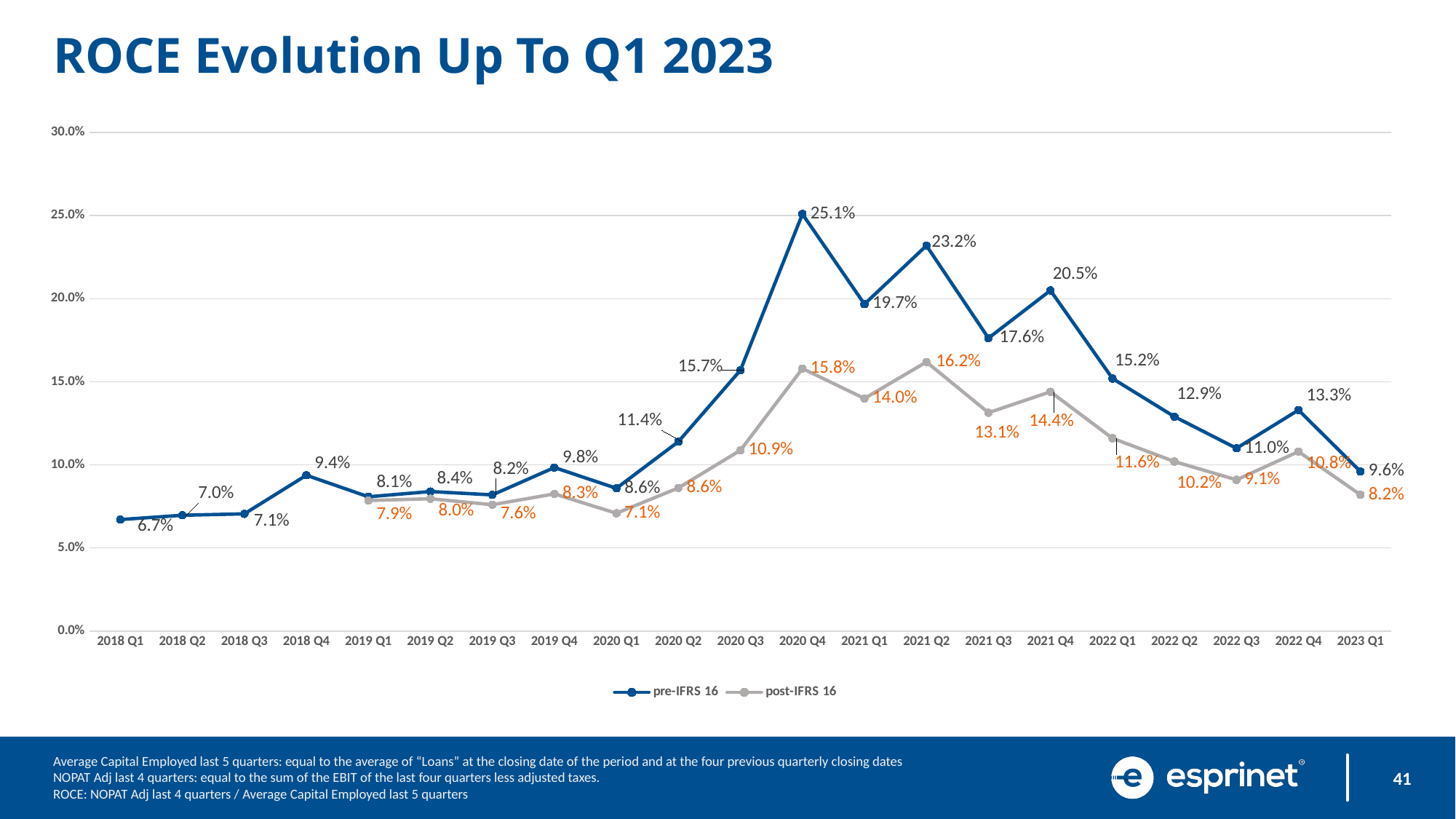
What is the difference between the pre-IFRS 16 and post-IFRS 16 ROCE values in 2020 Q4? 9.3% What kind of chart is shown on the slide? Line chart Does the pre-IFRS 16 ROCE rise or fall from 2020 Q4 to 2023 Q1? Fall How many series does the legend list? 2 What is the pre-IFRS 16 ROCE value for 2023 Q1? 9.6% Which quarter has the highest pre-IFRS 16 ROCE value? 2020 Q4 What is the post-IFRS 16 ROCE value for 2021 Q2? 16.2% Which quarter has the lowest pre-IFRS 16 ROCE value? 2018 Q1 What is the pre-IFRS 16 ROCE value for 2020 Q4? 25.1% Which quarter has the lowest post-IFRS 16 ROCE value? 2020 Q1 Which is larger, the pre-IFRS 16 ROCE in 2021 Q2 or in 2021 Q4? 2021 Q2 How many quarters are shown on the x axis? 21